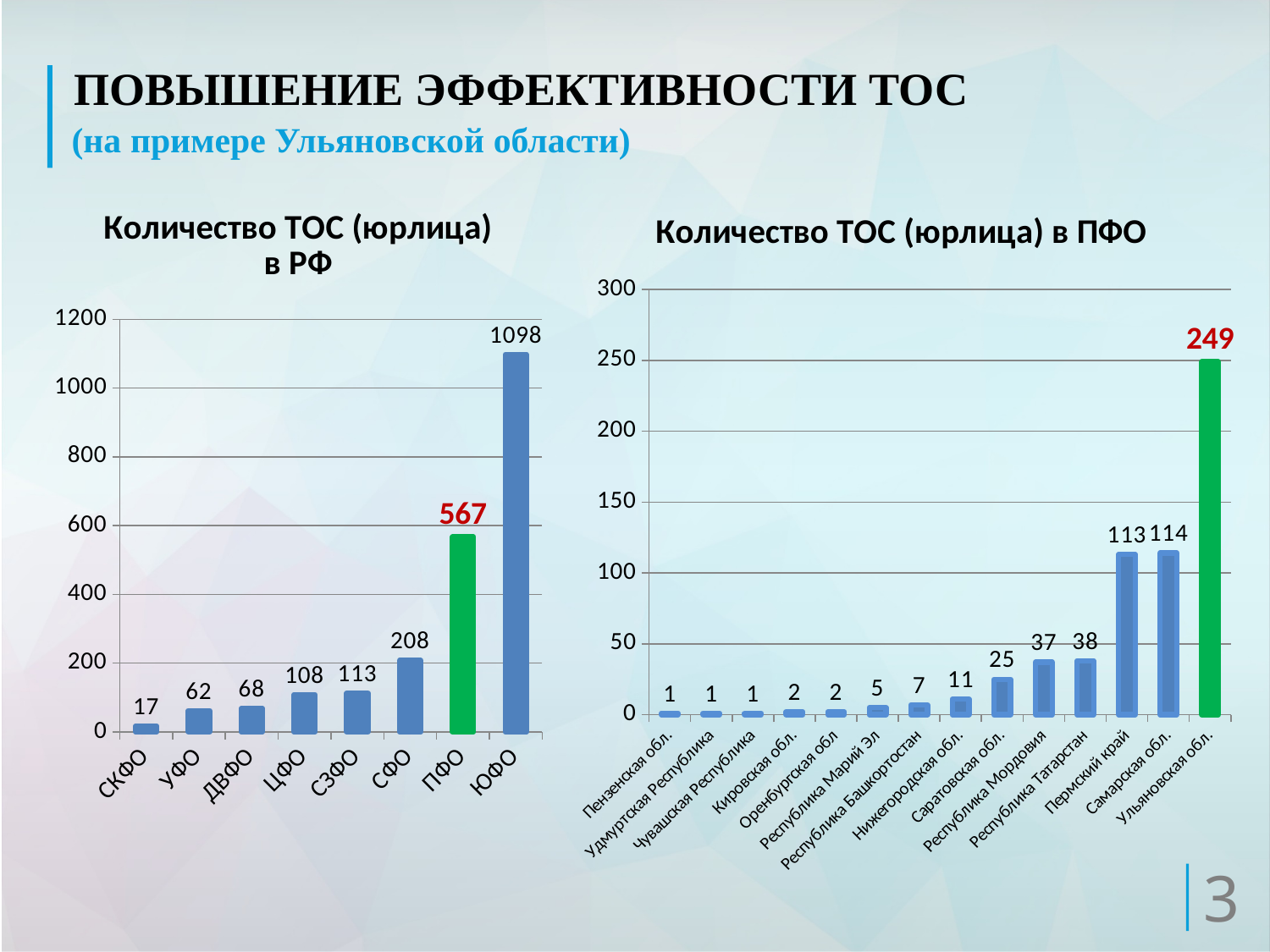
What type of chart is "Количество ТОС (юрлица) в ПФО"? bar chart In the chart "Количество ТОС (юрлица) в ПФО", which is larger, the value for Пермский край or the value for Самарская обл.? Самарская обл. In the chart "Количество ТОС (юрлица) в ПФО", what is the value for Ульяновская обл.? 249 In the chart "Количество ТОС (юрлица) в РФ", what is the value for ПФО? 567 In the chart "Количество ТОС (юрлица) в РФ", how many categories are shown on the x axis? 8 In the chart "Количество ТОС (юрлица) в ПФО", what is the value for Республика Татарстан? 38 In the chart "Количество ТОС (юрлица) в РФ", which category has the highest value? ЮФО In the chart "Количество ТОС (юрлица) в ПФО", what is the difference between the values for Ульяновская обл. and Самарская обл.? 135 In the chart "Количество ТОС (юрлица) в РФ", which category has the lowest value? СКФО In the chart "Количество ТОС (юрлица) в РФ", do the values rise or fall from left to right along the x axis? rise In the chart "Количество ТОС (юрлица) в ПФО", how many categories are shown on the x axis? 14 In the chart "Количество ТОС (юрлица) в РФ", what is the difference between the values for ЮФО and ПФО? 531